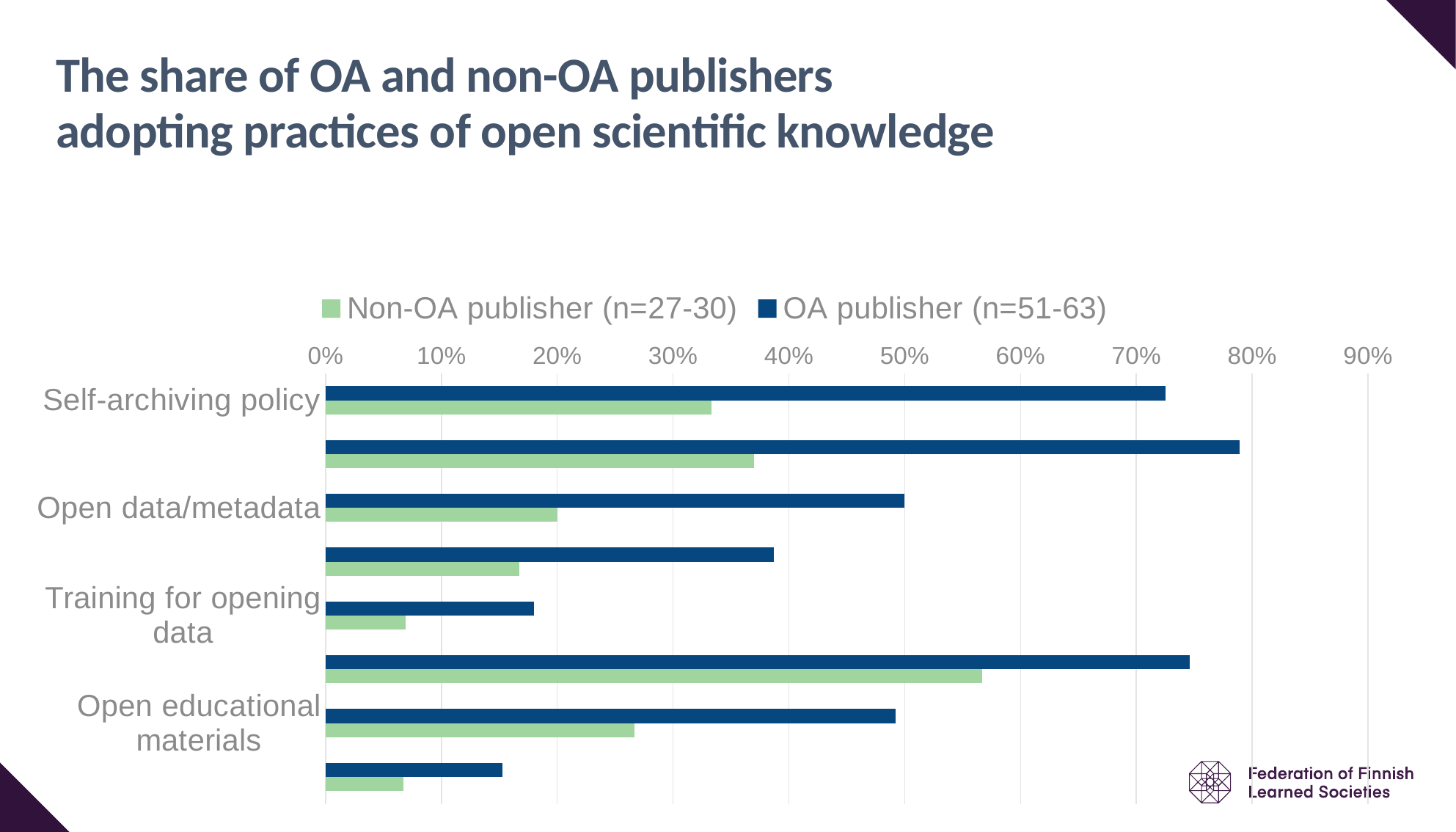
What kind of chart is shown on the slide? bar chart Which colour represents the Non-OA publisher series in the legend? green Is the OA publisher value for Open educational materials greater or less than 40%? greater Is the Non-OA publisher value for Self-archiving policy greater or less than 40%? less Is the Non-OA publisher value for Open data/metadata greater or less than 30%? less For Self-archiving policy, which series has the larger value, OA publisher or Non-OA publisher? OA publisher What is the highest value shown on the percentage axis? 90% How many series does the legend list? 2 For Open educational materials, which series has the larger value, OA publisher or Non-OA publisher? OA publisher